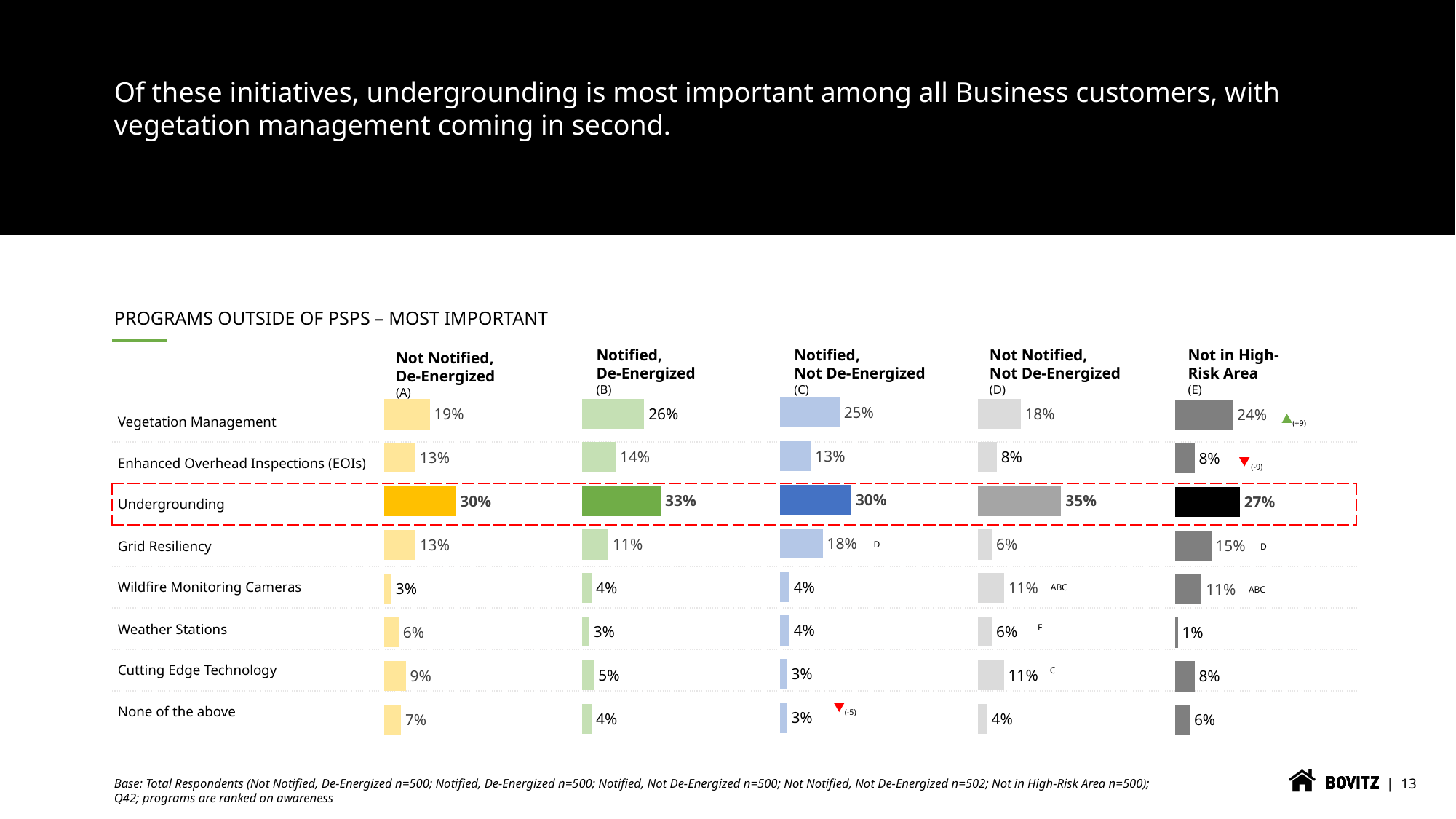
What type of chart is used on the slide? Bar chart What is the value for Weather Stations among Not in High-Risk Area (E) customers? 1% How many programs are listed in the chart? 8 How many customer segments are shown in the chart? 5 Which program has the lowest value among Not in High-Risk Area (E) customers? Weather Stations What is the value for Grid Resiliency among Notified, Not De-Energized (C) customers? 18% Which program has the highest value among Not Notified, De-Energized (A) customers? Undergrounding Which is larger for Cutting Edge Technology: the value for Not Notified, De-Energized (A) or Not Notified, Not De-Energized (D)? Not Notified, Not De-Energized (D) What is the value for Vegetation Management among Notified, De-Energized (B) customers? 26% What is the value for Undergrounding among Not Notified, Not De-Energized (D) customers? 35% What is the difference between the Undergrounding values for Notified, De-Energized (B) and Not in High-Risk Area (E)? 6 percentage points Which segment has the highest value for Undergrounding? Not Notified, Not De-Energized (D)